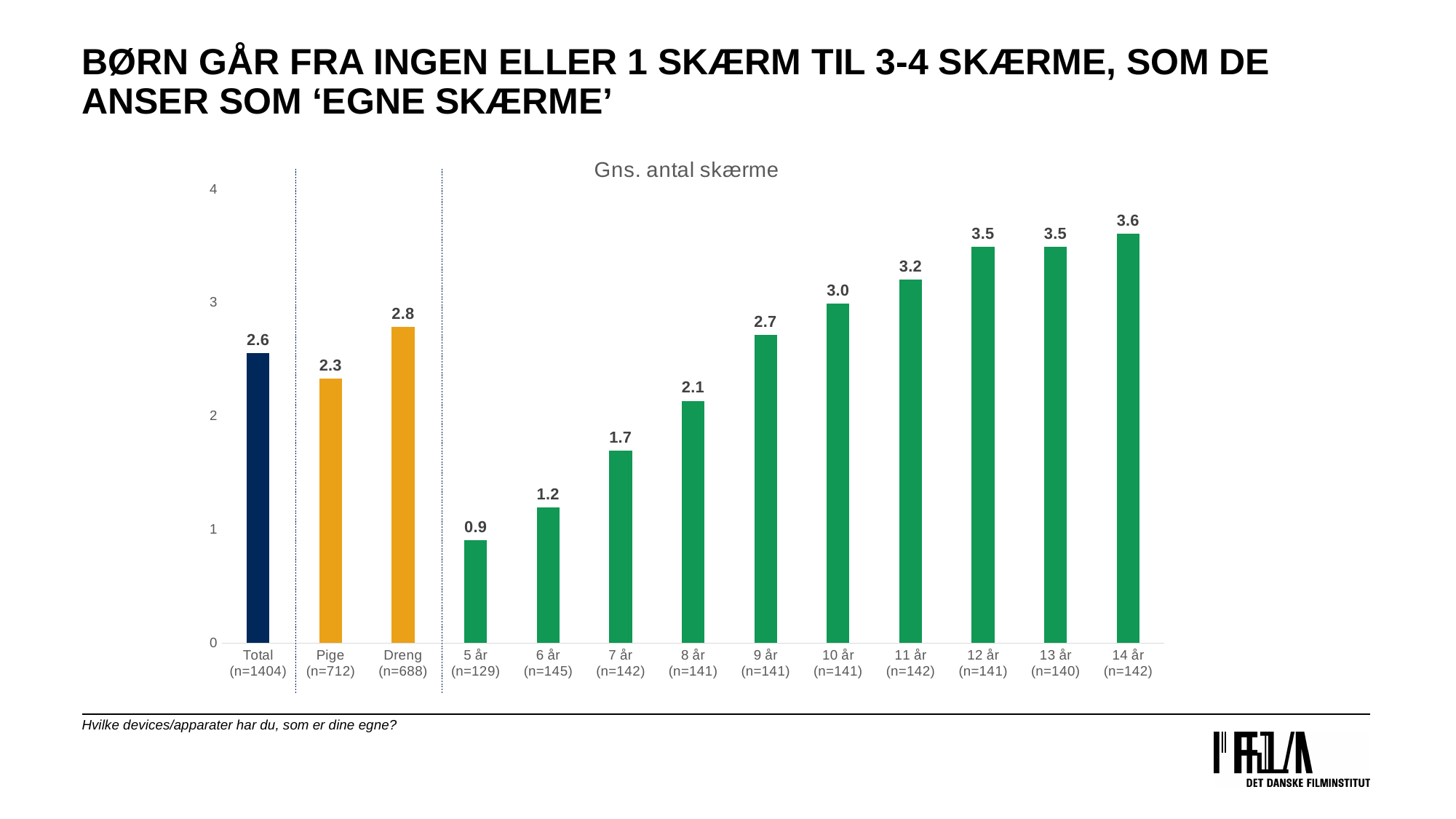
What is the value for Total (n=1404)? 2.6 What is the value for 10 år (n=141)? 3.0 What kind of chart is this? Bar chart Which category has the highest value? 14 år (n=142) Which category has the lowest value? 5 år (n=129) What colour are the bars for the age groups (5 år to 14 år)? Green How many categories are shown on the x axis? 13 Do the values rise or fall from 5 år to 14 år? Rise What is the title of the chart? Gns. antal skærme Which is larger, the value for 9 år or the value for 8 år? 9 år What is the difference between the values for Dreng and Pige? 0.5 What is the value for Pige (n=712)? 2.3